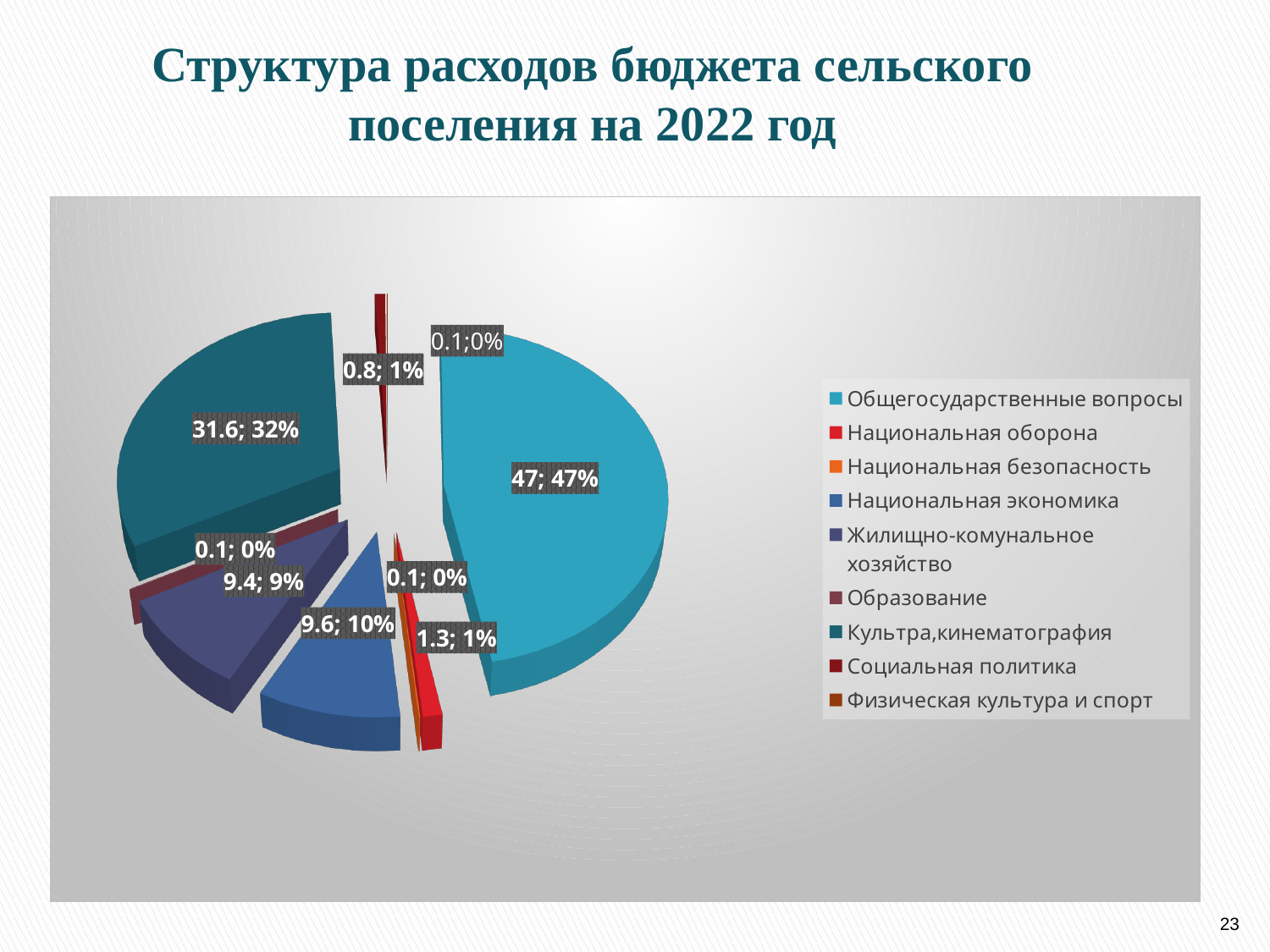
What is the difference between the values for Общегосударственные вопросы and Культра,кинематография? 15.4 What value and share are shown for Национальная оборона? 1.3; 1% What value and share are shown for Общегосударственные вопросы? 47; 47% What value and share are shown for Культра,кинематография? 31.6; 32% Which category has the largest slice of the pie? Общегосударственные вопросы What value and share are shown for Жилищно-коммунальное хозяйство? 9.4; 9% What kind of chart is shown on the slide? pie chart What value and share are shown for Национальная экономика? 9.6; 10% How many categories does the legend of the pie chart list? 9 Which is larger, the slice for Национальная экономика or the slice for Национальная оборона? Национальная экономика What value and share are shown for Социальная политика? 0.8; 1% What percentage share of the pie does Культра,кинематография have? 32%